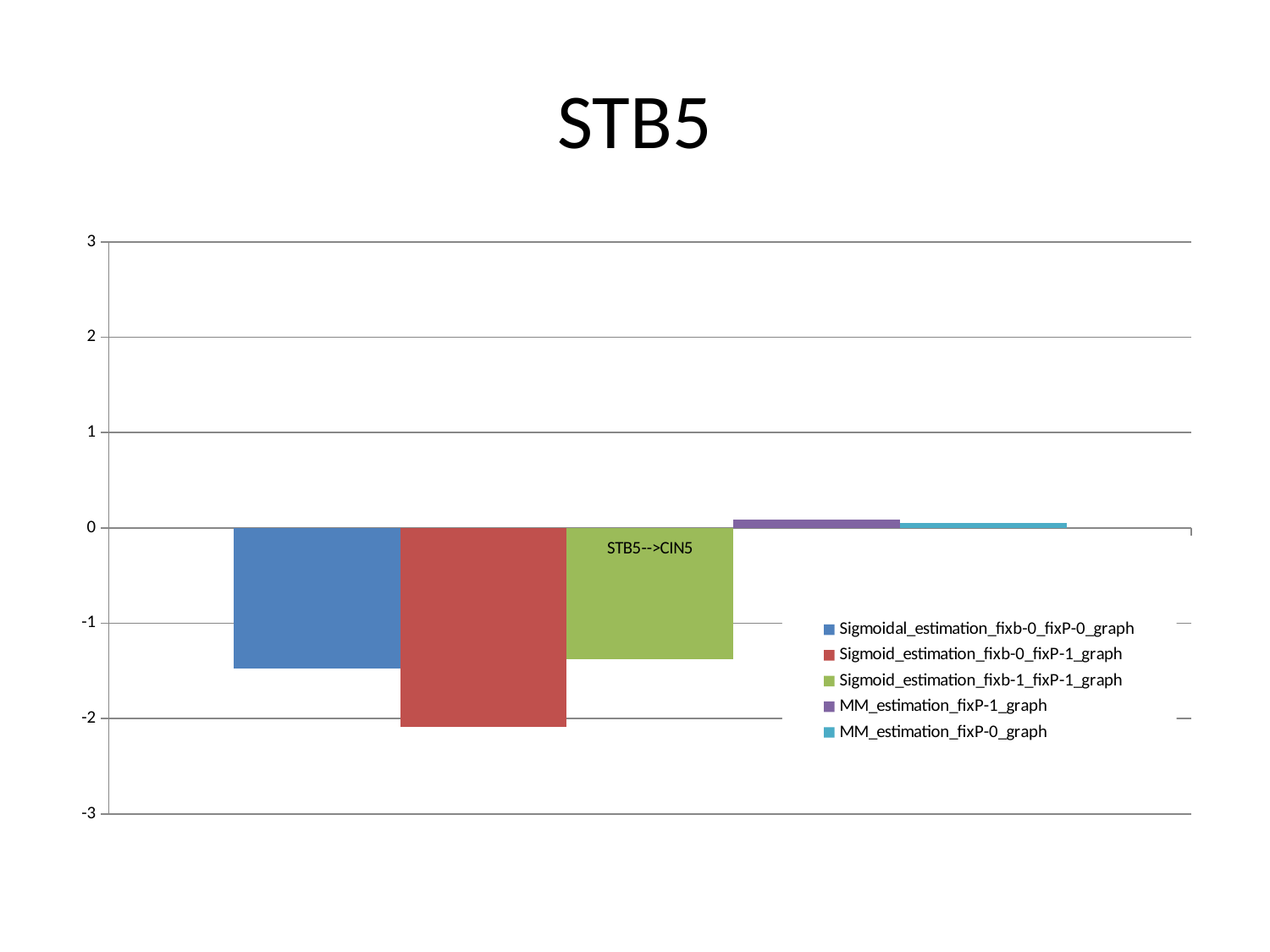
Which is larger, the value for MM_estimation_fixP-0_graph or the value for Sigmoid_estimation_fixb-1_fixP-1_graph? MM_estimation_fixP-0_graph How many categories are plotted on the x axis? 1 What kind of chart is shown on the slide? bar chart What is the title of the chart? STB5 Is the value for Sigmoid_estimation_fixb-0_fixP-1_graph greater or less than -2? less Which series has the lowest value for STB5-->CIN5? Sigmoid_estimation_fixb-0_fixP-1_graph Is the value for Sigmoid_estimation_fixb-1_fixP-1_graph greater or less than -1? less How many series does the legend list? 5 Is the value for MM_estimation_fixP-1_graph greater or less than 0? greater Which is larger, the value for Sigmoidal_estimation_fixb-0_fixP-0_graph or the value for Sigmoid_estimation_fixb-0_fixP-1_graph? Sigmoidal_estimation_fixb-0_fixP-0_graph What is the label of the category shown on the x axis? STB5-->CIN5